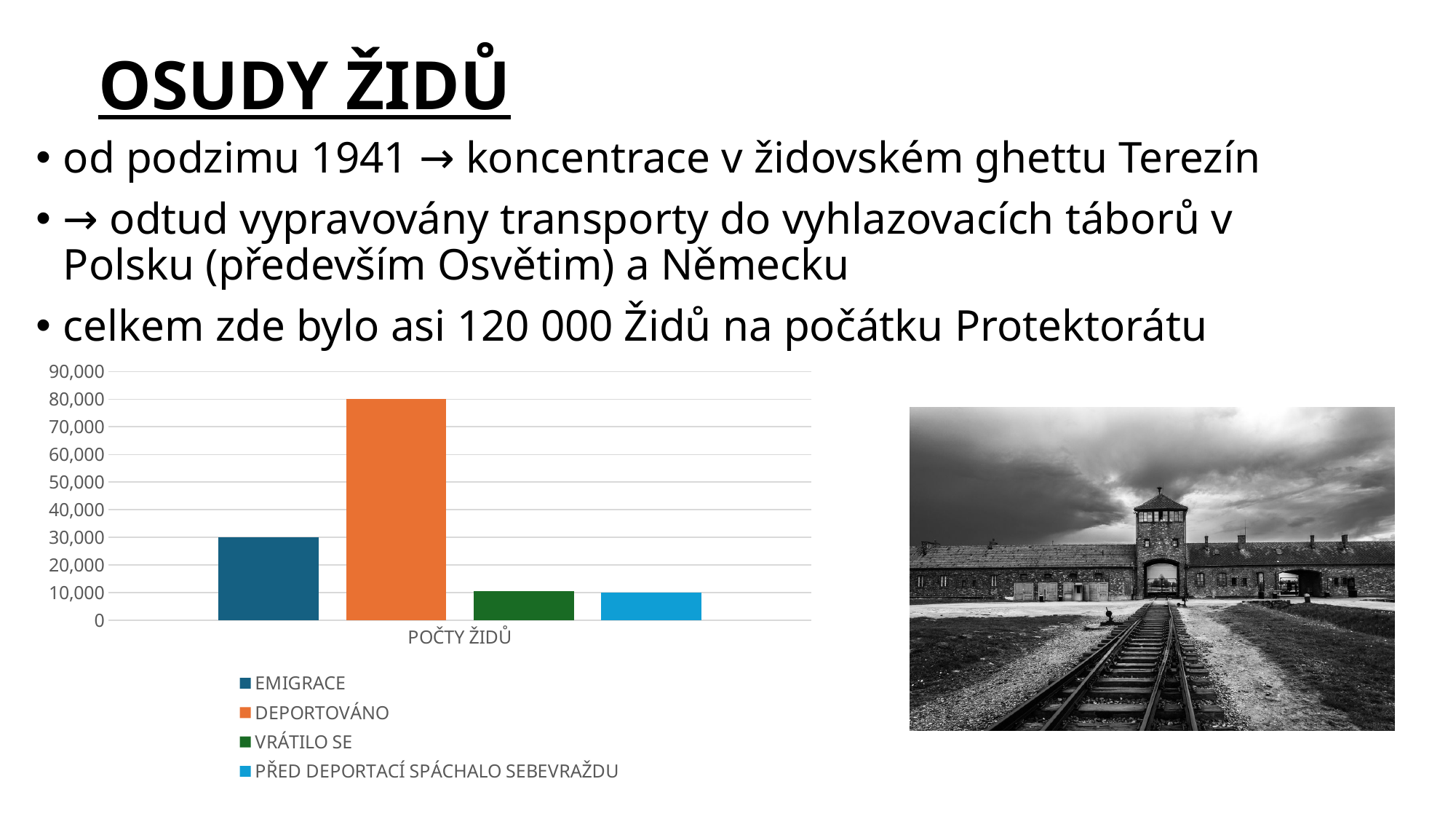
Which is larger, the EMIGRACE value or the VRÁTILO SE value? EMIGRACE What is the category label shown on the x axis of the chart? POČTY ŽIDŮ What is the value of the EMIGRACE bar? 30,000 How many categories are shown on the x axis of the chart? 1 Is the value for DEPORTOVÁNO greater or less than 70,000? greater What kind of chart is shown on the slide? bar chart What colour is the DEPORTOVÁNO series in the chart? orange How many series does the chart legend list? 4 Is the value for VRÁTILO SE greater or less than 20,000? less Which series has the highest value in the chart? DEPORTOVÁNO What is the difference between the DEPORTOVÁNO and EMIGRACE values? 50,000 What is the value of the DEPORTOVÁNO bar? 80,000